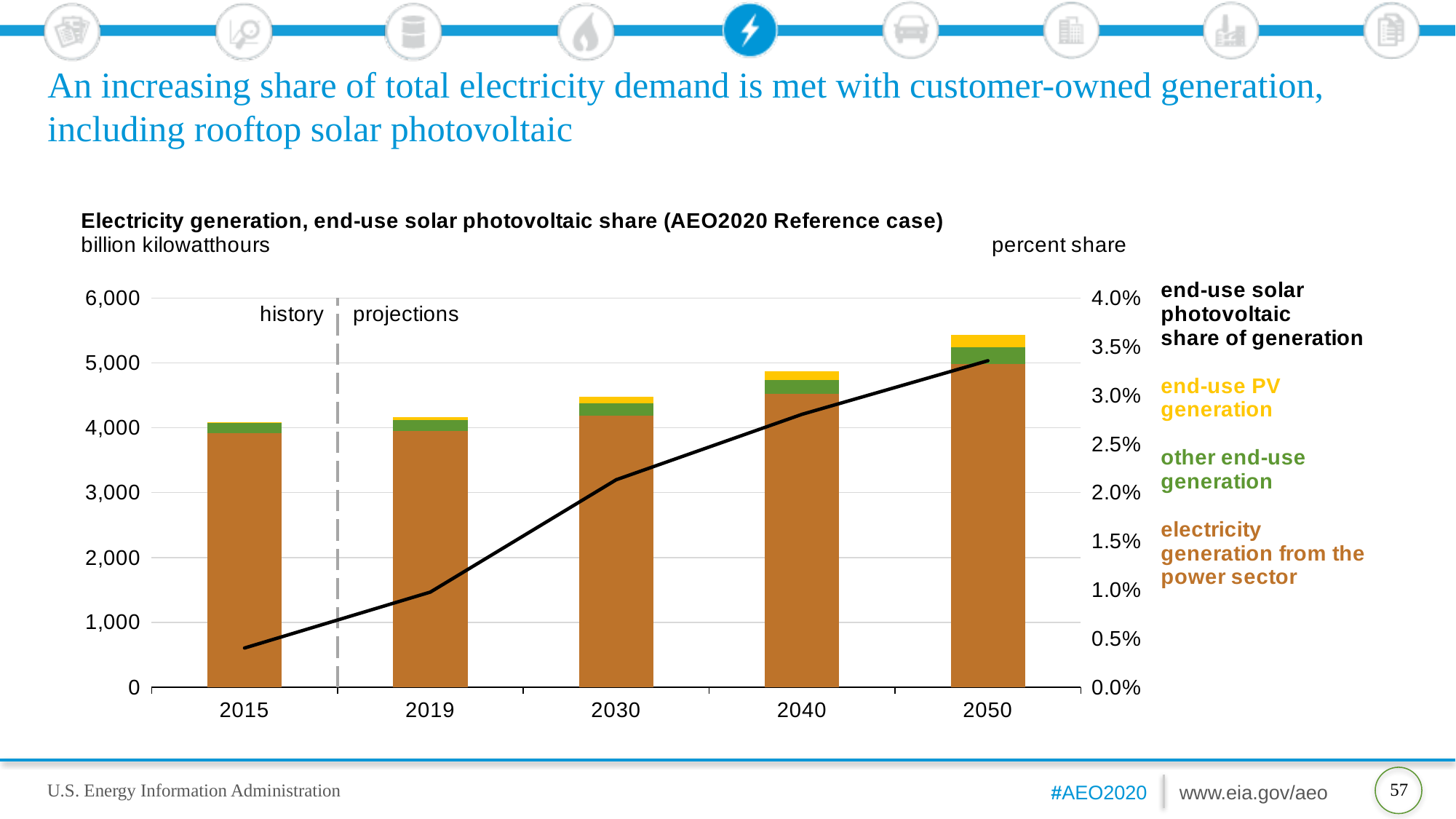
Which legend entry is shown in yellow? end-use PV generation How many years are shown along the x axis of the chart? 5 Is the total stacked bar for 2030 greater or less than 5,000 billion kilowatthours? less What unit is shown on the left axis of the chart? billion kilowatthours Is the end-use solar photovoltaic share of generation in 2050 greater or less than 3.0%? greater Does the end-use solar photovoltaic share of generation line rise or fall from 2015 to 2050? rise Is the end-use solar photovoltaic share of generation in 2015 greater or less than 0.5%? less Which year has the tallest stacked bar for total electricity generation? 2050 How many entries does the chart's legend list? 4 What kind of chart is used to show electricity generation by source on this slide? bar chart Which is larger, the total stacked bar for 2050 or the total stacked bar for 2015? 2050